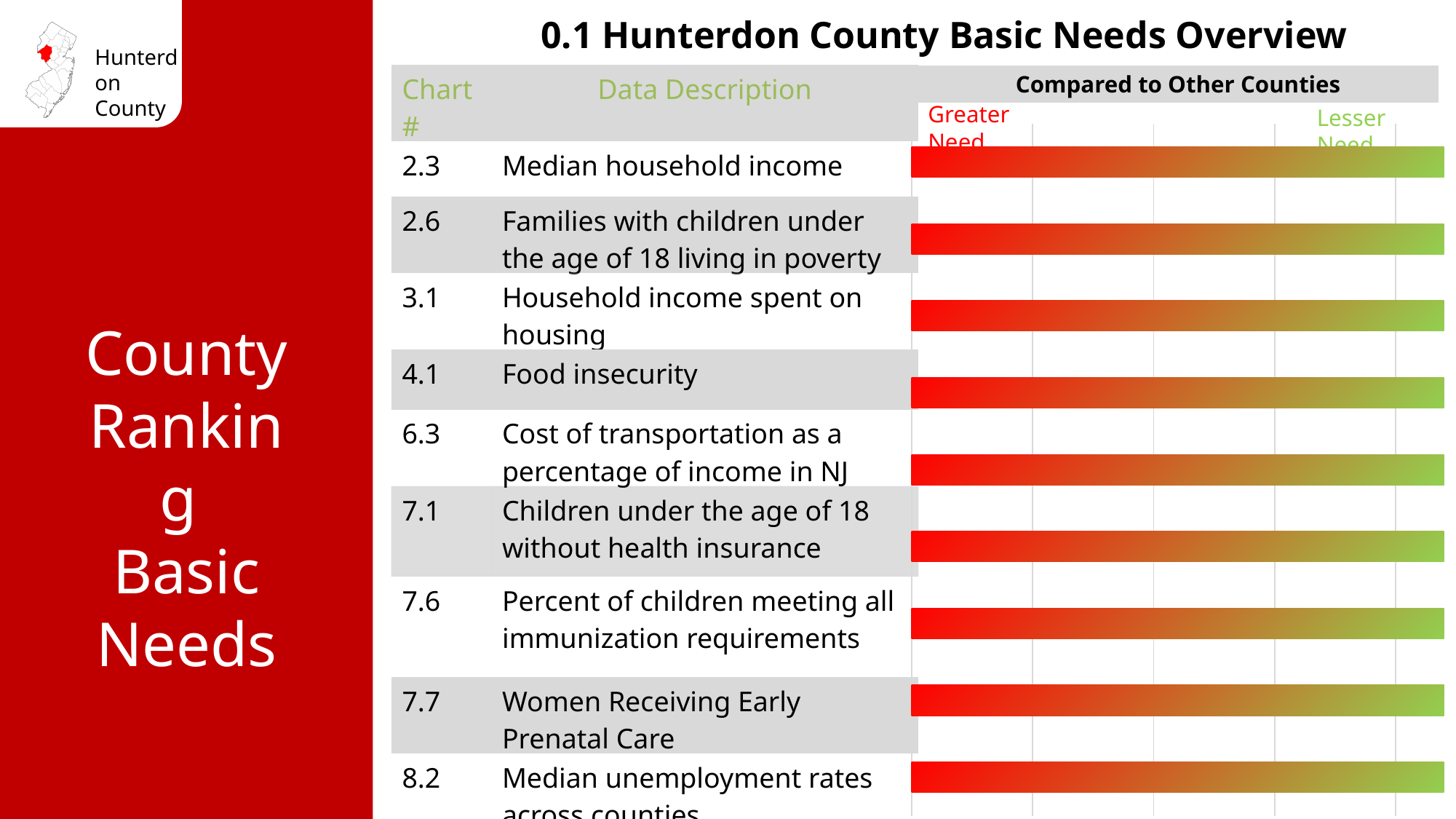
Which data description is listed for chart number 7.7? Women Receiving Early Prenatal Care Which chart number is listed for the row 'Median household income'? 2.3 Which chart number is listed for the row 'Food insecurity'? 4.1 Which data description is listed for chart number 3.1? Household income spent on housing What kind of chart is shown on the slide? bar chart What label appears at the left end of the chart's scale, above the bars? Greater Need How many bars are plotted in the chart? 9